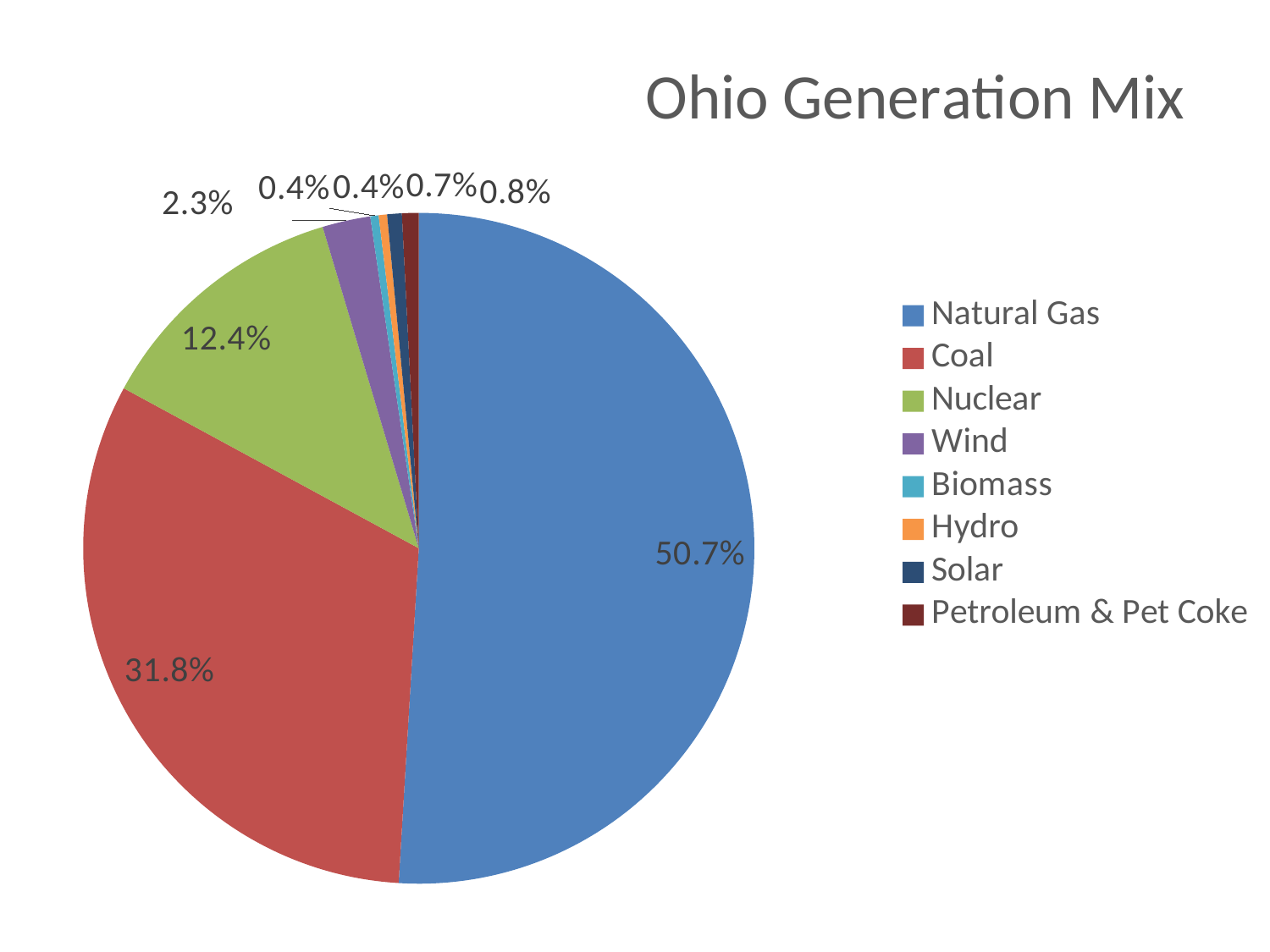
What colour is the Nuclear slice? Green Which category has the largest slice of the pie? Natural Gas What is the title of the chart? Ohio Generation Mix What share of the pie does Petroleum & Pet Coke have? 0.8% What kind of chart is shown on the slide? Pie chart What share of the pie does Wind have? 2.3% What share of the pie does Natural Gas have? 50.7% How many categories does the legend list? 8 What is the difference between the Natural Gas share and the Coal share? 18.9% Which is larger, the Coal share or the Nuclear share? Coal